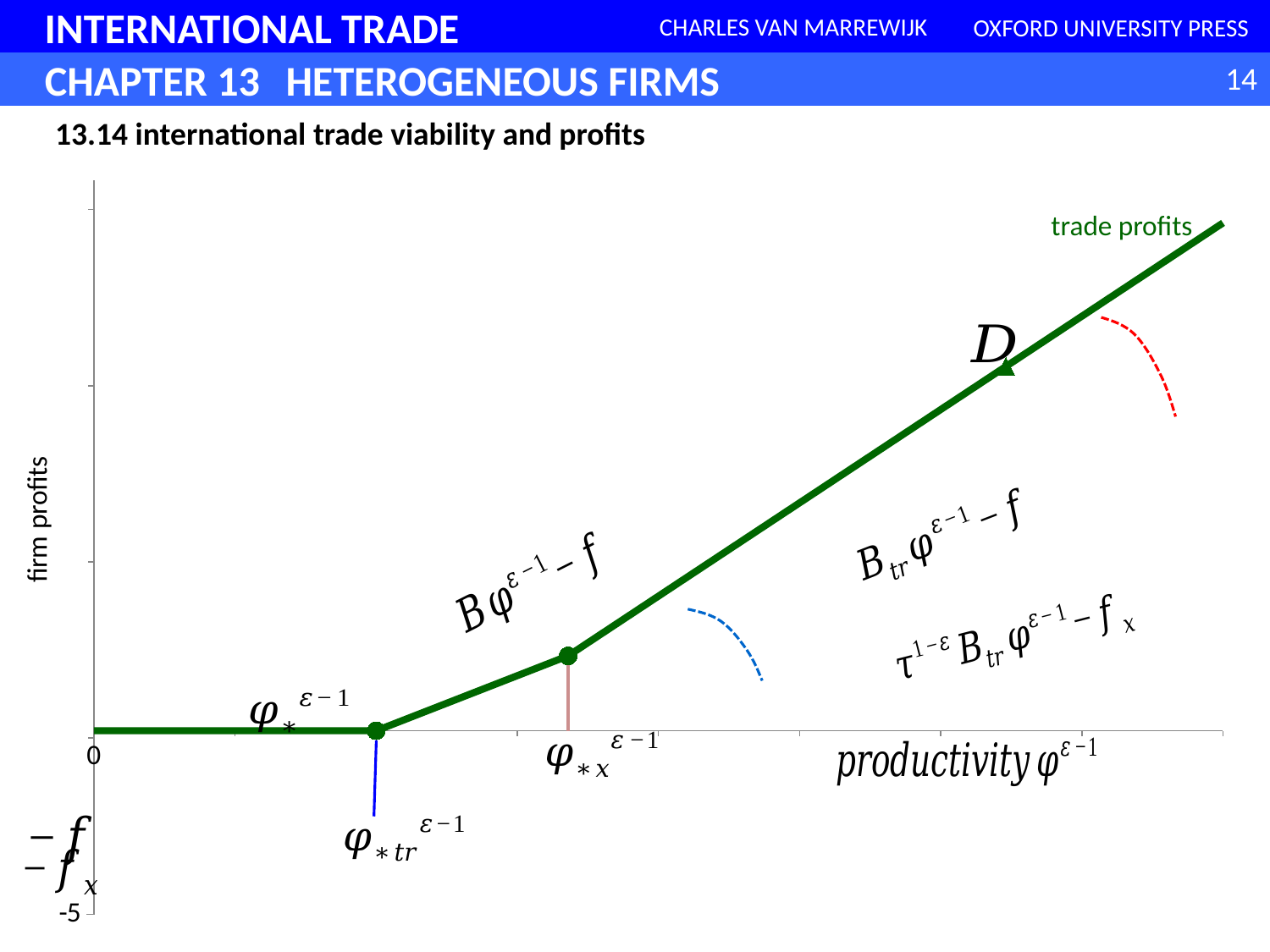
What kind of chart is shown on the slide? line chart Which is larger: trade profits at the point marked φ*tr^(ε-1) or at the point marked φ*x^(ε-1)? φ*x^(ε-1) Is the value of trade profits at the far left of the chart (productivity 0) greater or less than -5? greater How many plotted series are labelled on the chart? 1 What is the title of the chart? 13.14 international trade viability and profits Which is larger: trade profits at point D or trade profits at the point marked φ*x^(ε-1)? point D Is the value of trade profits at point D greater or less than 0? greater Do the trade profits rise or fall as productivity increases along the x axis? rise What is the label on the vertical axis? firm profits Between the points marked φ*tr^(ε-1) and φ*x^(ε-1), does the trade profits line rise or fall? rise To the left of the point marked φ*tr^(ε-1), is the trade profits line flat, rising or falling? flat